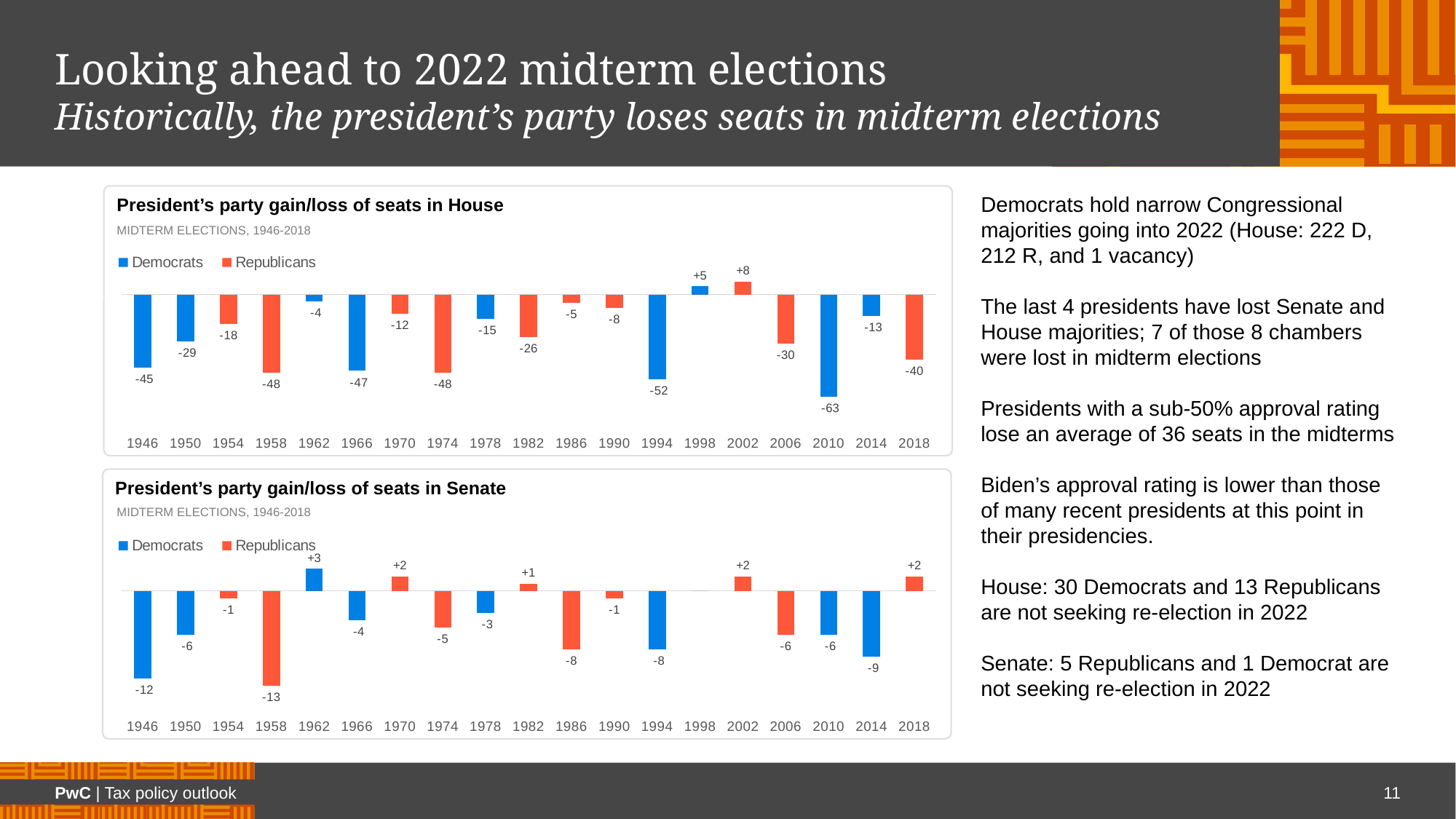
What type of chart is used for the President's party gain/loss of seats in House? Bar chart In the House chart, what was the president's party gain/loss of seats in 2010? -63 In the Senate chart, what was the president's party gain/loss of seats in 1958? -13 In the House chart, which midterm year shows the largest gain of seats? 2002 In the House chart, what was the president's party gain/loss of seats in 1994? -52 In the Senate chart, which midterm year shows the largest gain of seats? 1962 In the Senate chart, what was the president's party gain/loss of seats in 2014? -9 How many midterm election years are shown on the x axis of the House chart? 19 How many series does the legend of the Senate chart list? 2 In the House chart, which midterm year shows the largest loss of seats? 2010 In the House chart, what is the difference between the 2010 value and the 2014 value? 50 In the Senate chart, which is larger in magnitude, the loss in 1946 or the loss in 1958? 1958